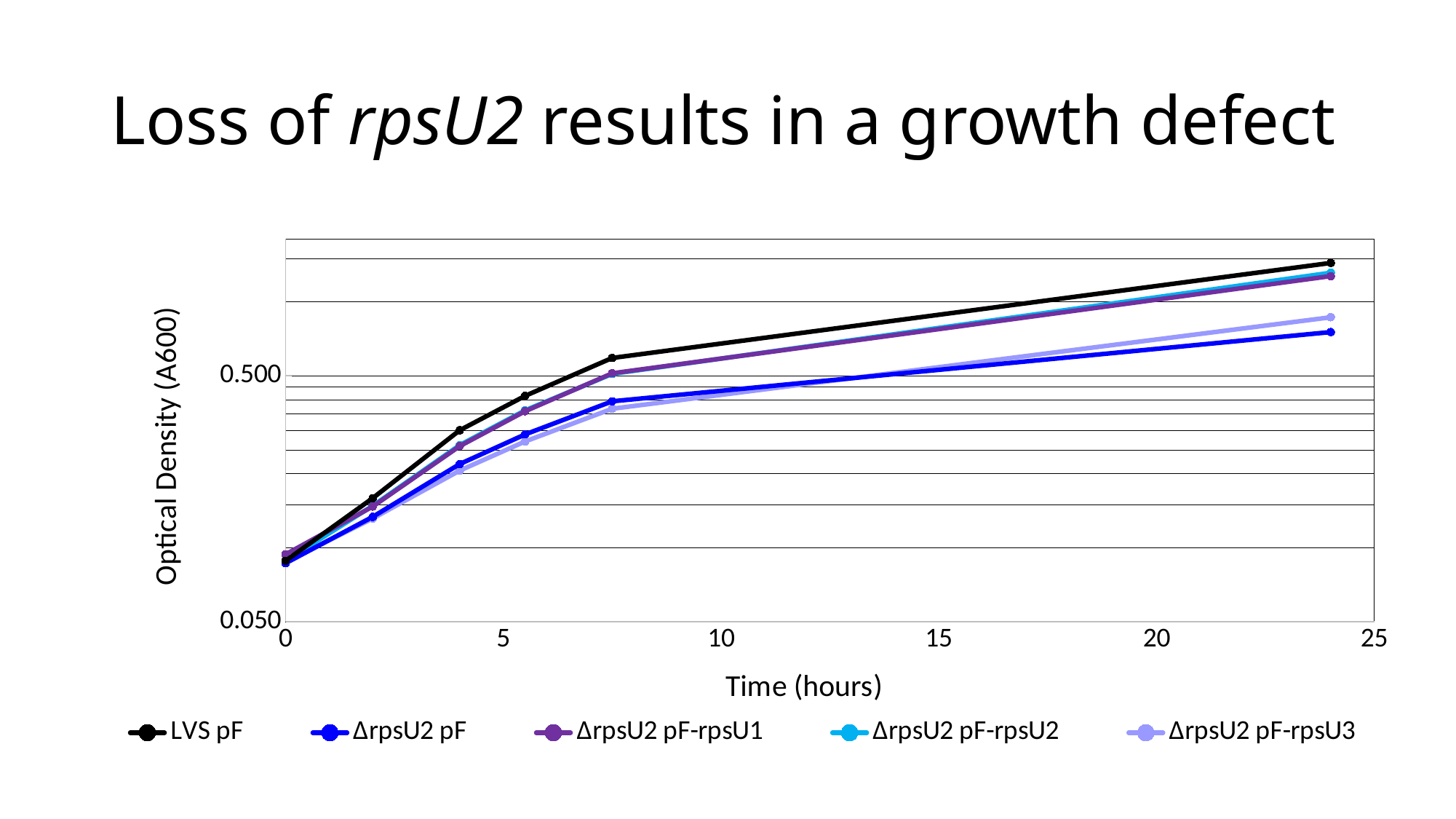
What is the label of the y axis? Optical Density (A600) Is the optical density for ΔrpsU2 pF at 7.5 hours greater or less than 0.500? less Which series has the lowest optical density at 24 hours? ΔrpsU2 pF Which series has the highest optical density at 24 hours? LVS pF Do the optical density values rise or fall as time increases? rise Is the optical density for LVS pF at 0 hours greater or less than 0.500? less What is the label of the x axis? Time (hours) What kind of chart is shown on the slide? line chart How many series does the legend list? 5 How many time points are plotted for each series? 6 Is the optical density for LVS pF at 24 hours greater or less than 0.500? greater At 24 hours, which series has the larger optical density, LVS pF or ΔrpsU2 pF? LVS pF